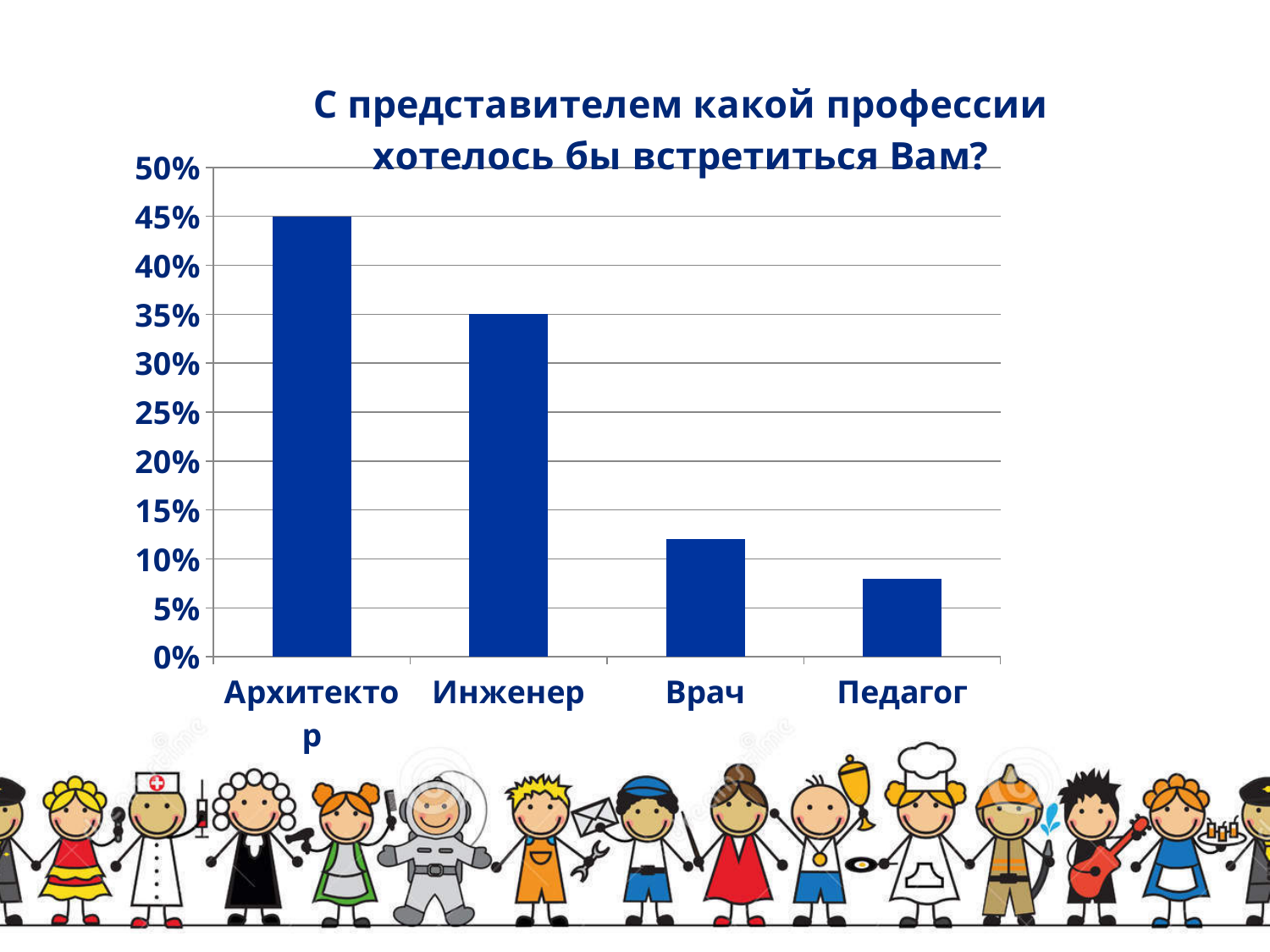
What is the title of the chart? С представителем какой профессии хотелось бы встретиться Вам? What is the value for Архитектор? 45% What is the difference between the values for Архитектор and Инженер? 10% What kind of chart is shown on the slide? Bar chart Which is larger, the value for Врач or the value for Педагог? Врач Is the value for Врач greater or less than 10%? greater Which category has the highest value? Архитектор Do the values rise or fall from left to right along the x axis? Fall What is the value for Инженер? 35% Which category has the lowest value? Педагог Is the value for Педагог greater or less than 10%? less How many categories are shown on the x axis? 4